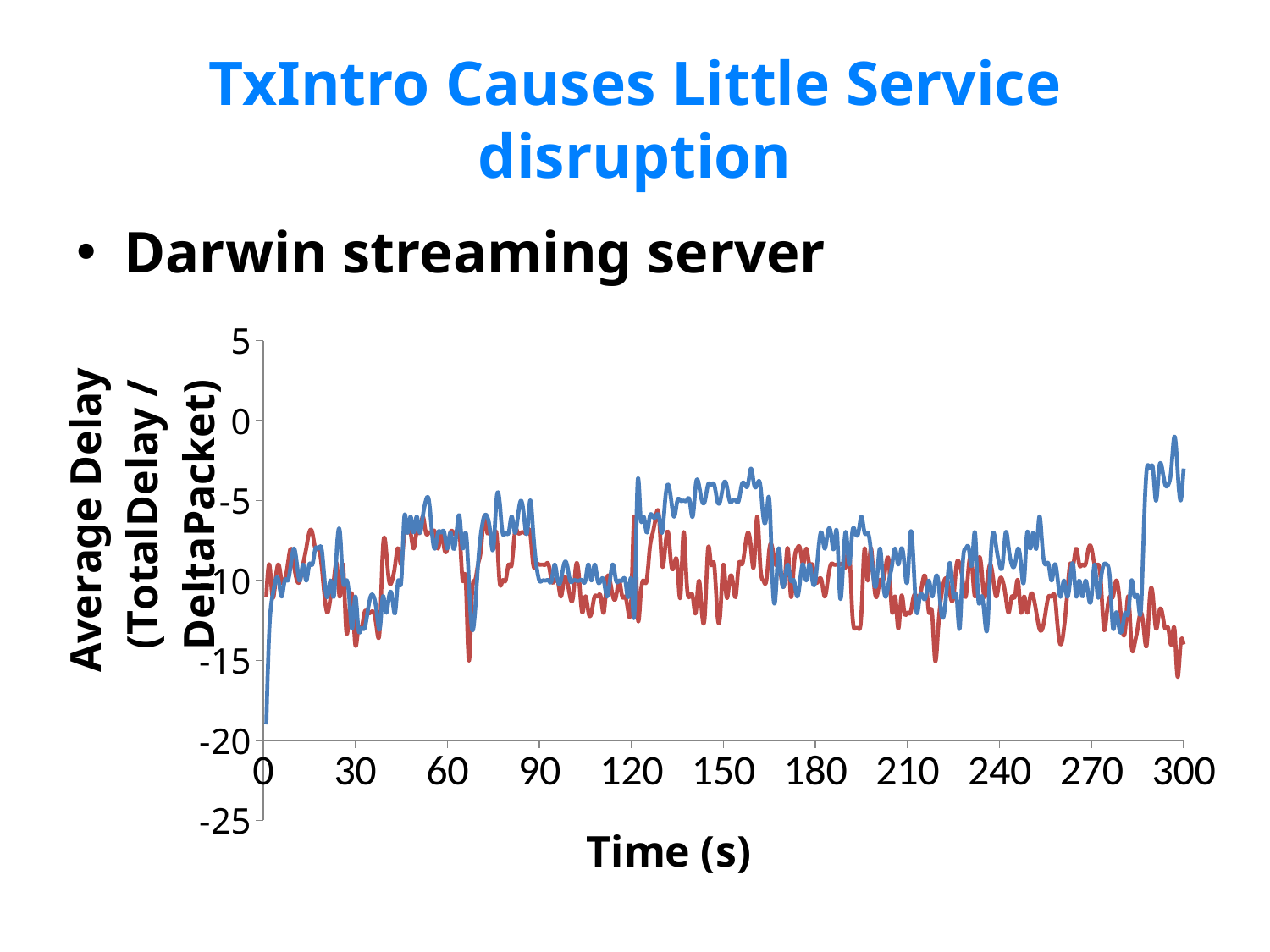
Near time 300, which line has the higher value, the blue line or the red line? blue line Near time 290, is the peak value of the blue line greater or less than -5? greater What is the title of the x axis of the chart? Time (s) What kind of chart is shown on the slide? line chart What is the highest tick value shown on the y axis? 5 How many lines (series) are plotted on the chart? 2 What is the largest value shown on the x axis? 300 What is the lowest tick value shown on the y axis? -25 How many tick labels are shown on the x axis? 11 Near time 300, is the value of the red line greater or less than -10? less What is the title of the y axis of the chart? Average Delay (TotalDelay / DeltaPacket)